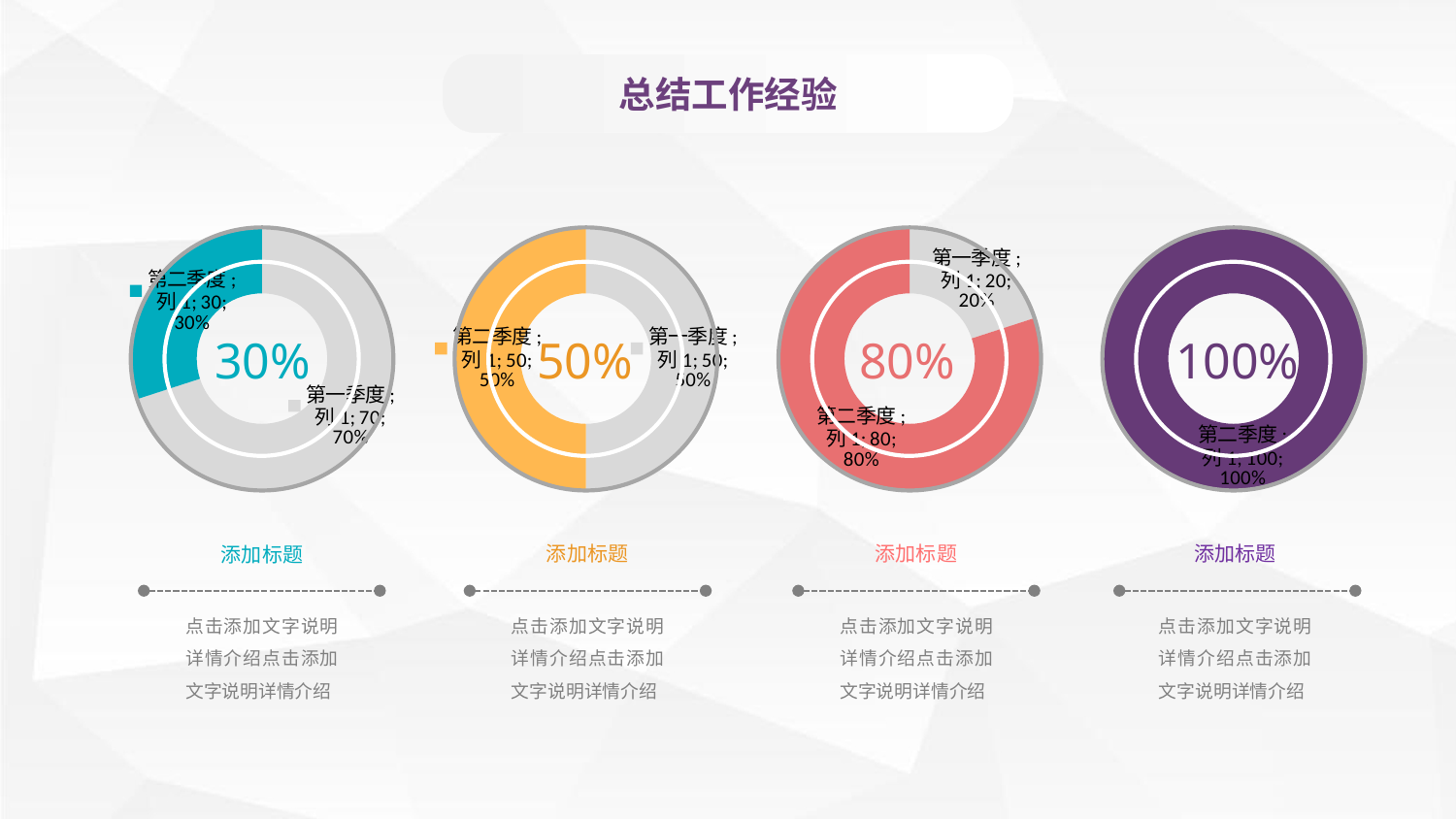
In the third doughnut chart from the left, which slice is the largest? 第二季度 In the second doughnut chart from the left, what percentage is shown for 第二季度? 50% In the third doughnut chart from the left, what percentage is shown for 第二季度? 80% What type of chart is the leftmost chart on the slide? Doughnut chart In the rightmost doughnut chart, what percentage is shown for 第二季度? 100% In the leftmost doughnut chart, what percentage is shown for 第一季度? 70% In the leftmost doughnut chart, which slice is larger, 第一季度 or 第二季度? 第一季度 How many doughnut charts are shown on the slide? 4 In the third doughnut chart from the left, what percentage is shown for 第一季度? 20% In the leftmost doughnut chart, what percentage is shown for 第二季度? 30% In the leftmost doughnut chart, what is the difference between the 第一季度 and 第二季度 percentages? 40% In the second doughnut chart from the left, what percentage is shown for 第一季度? 50%